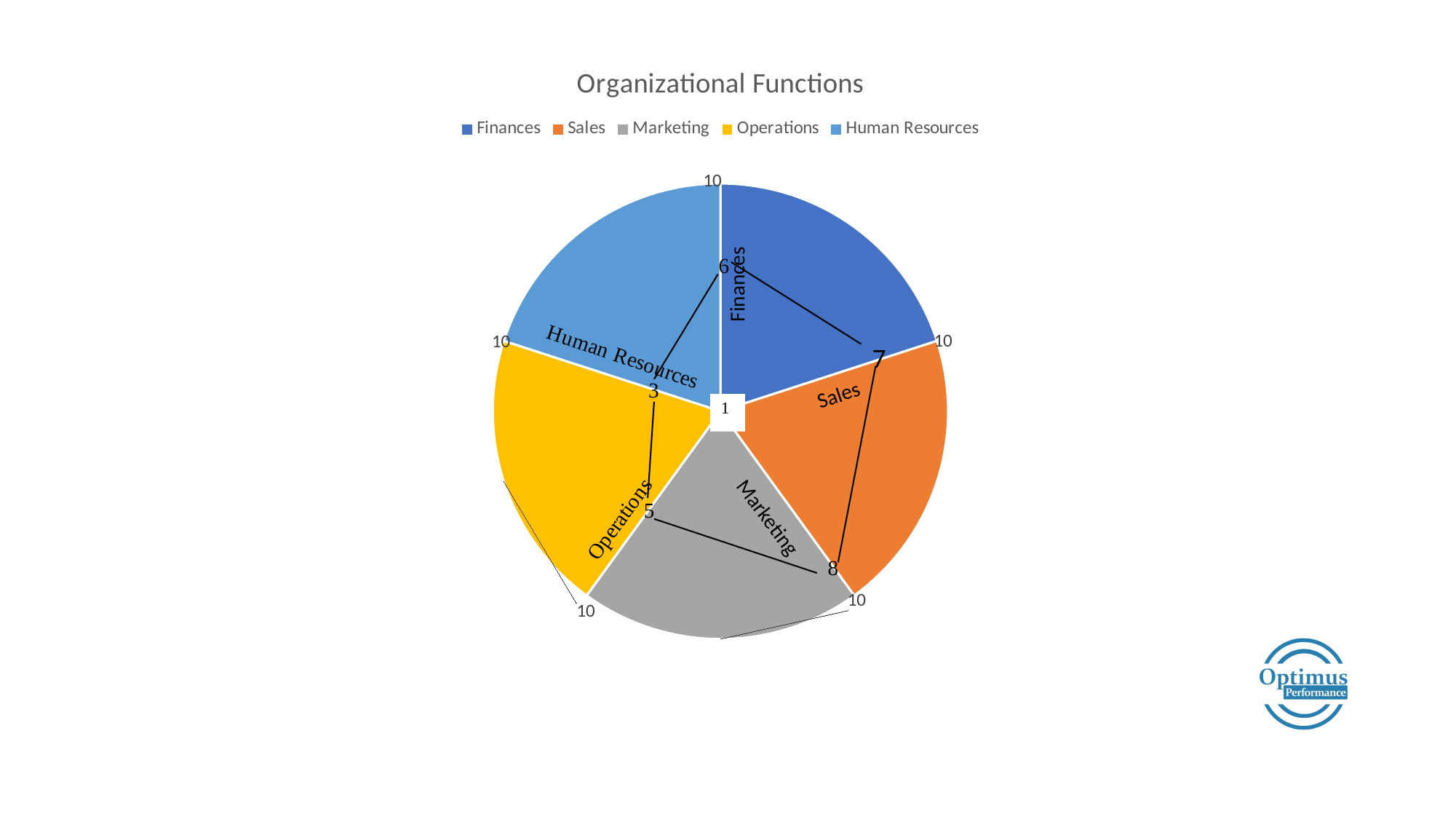
Is the value for Sales greater or less than 5? greater What is the title of the chart? Organizational Functions How many entries does the legend list? 5 What kind of chart is shown on the slide? pie chart What is the difference between the values for Marketing and Operations? 0 How many slices does the pie chart have? 5 What share of the pie does the Operations slice represent? 20% Which colour represents Marketing in the pie chart? grey